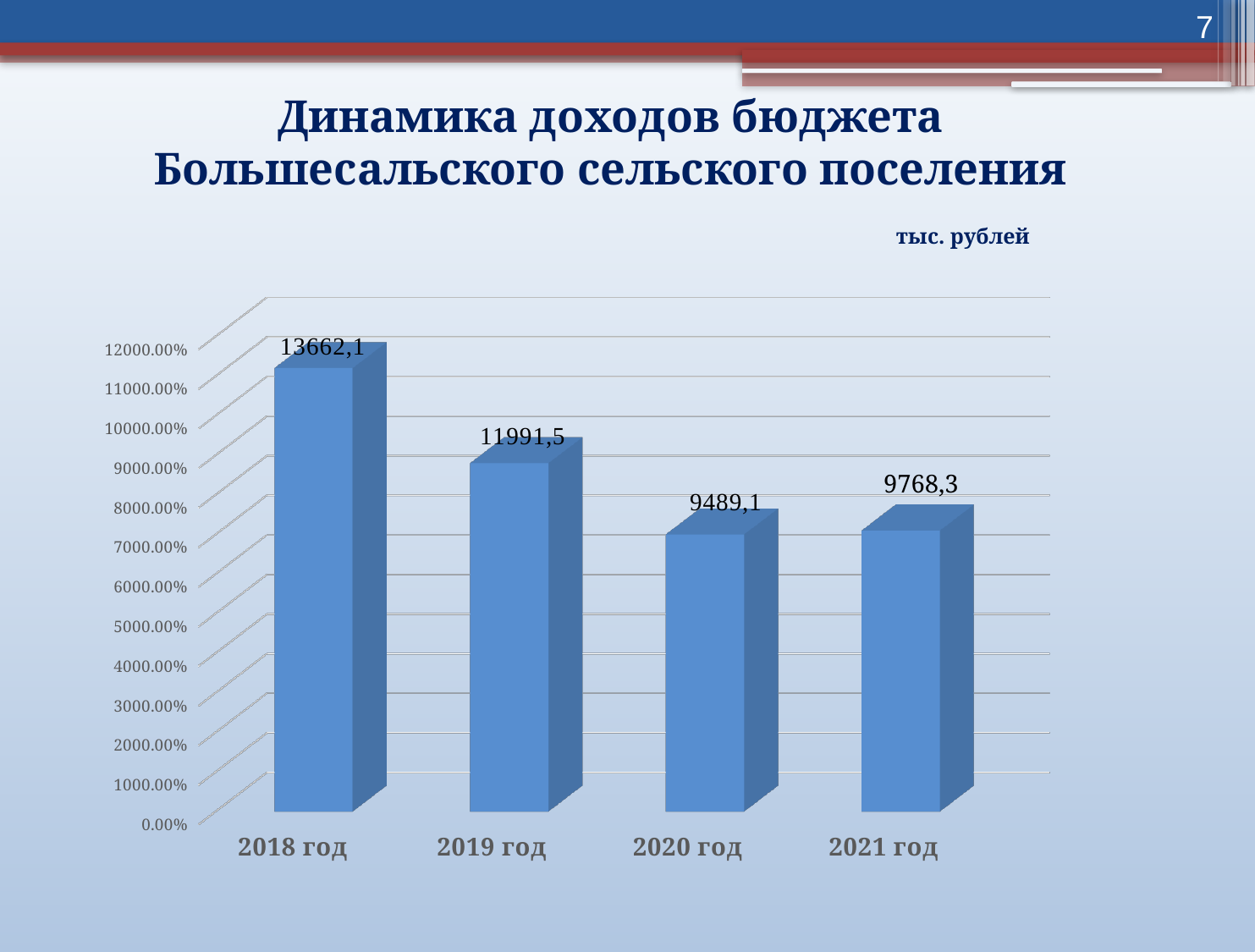
How many years are shown on the chart? 4 What is the value for 2018 год? 13662,1 What kind of chart is shown on the slide? bar chart Do the values rise or fall from 2018 год to 2020 год? fall Which is larger, the value for 2020 год or the value for 2021 год? 2021 год What is the value for 2021 год? 9768,3 What is the difference between the values for 2018 год and 2019 год? 1670,6 Which year has the lowest value? 2020 год What is the value for 2020 год? 9489,1 Which year has the highest value? 2018 год What is the value for 2019 год? 11991,5 What is the difference between the values for 2021 год and 2020 год? 279,2